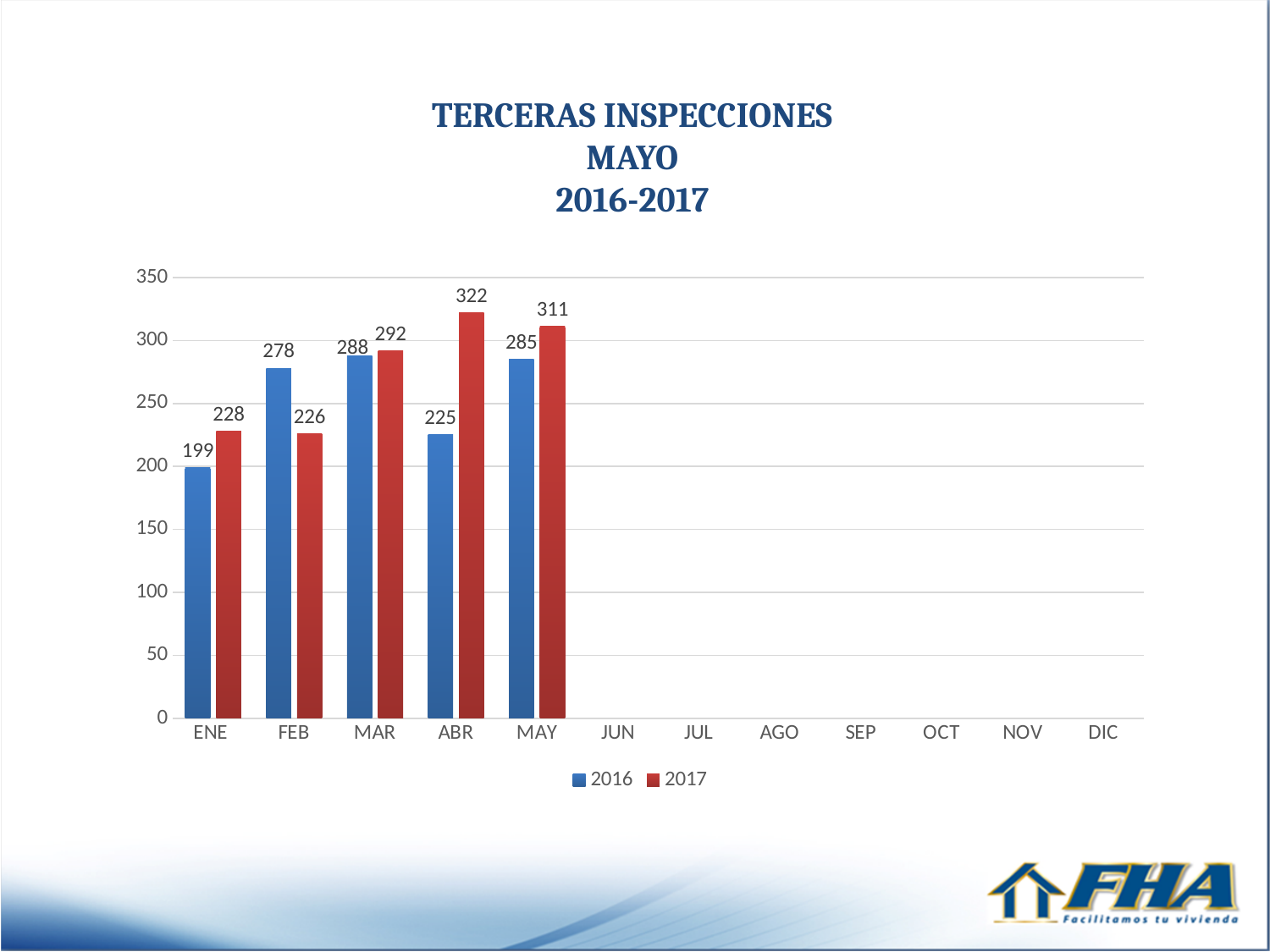
Which colour represents the 2017 series? red In which month is the 2016 value lowest? ENE What is the value for 2017 in MAY? 311 What is the value for 2017 in ABR? 322 Which is larger in FEB, the 2016 value or the 2017 value? 2016 In which month is the 2017 value highest? ABR What is the difference between the 2017 and 2016 values in ABR? 97 What is the value for 2016 in ENE? 199 What kind of chart is shown on the slide? bar chart How many series does the legend list? 2 Is the 2016 value for MAR greater or less than 250? greater How many months have data plotted in the chart? 5